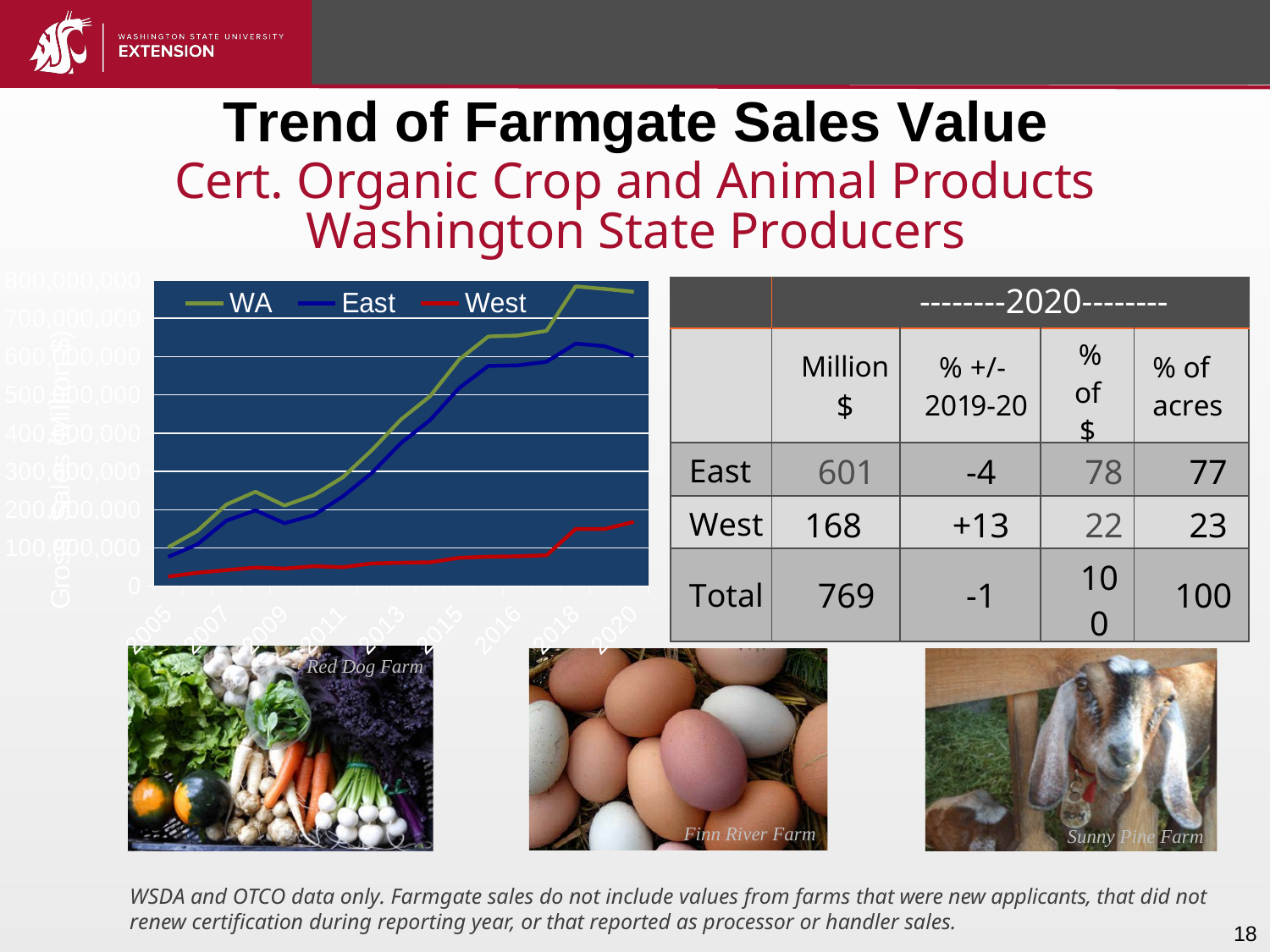
What is the first year shown on the chart's x axis? 2005 What are the three series named in the chart's legend? WA, East, West Is the value for West in 2020 greater or less than 200,000,000? less How many series does the chart's legend list? 3 What kind of chart is shown on the slide? line chart Do the WA values generally rise or fall from 2005 to 2020? rise Do the West values generally rise or fall from 2005 to 2020? rise Which series has the highest values across the chart? WA In 2020, which series has the larger value, East or West? East Which series is drawn in red on the chart? West Is the value for WA in 2020 greater or less than 700,000,000? greater Which series has the lowest values across the chart? West